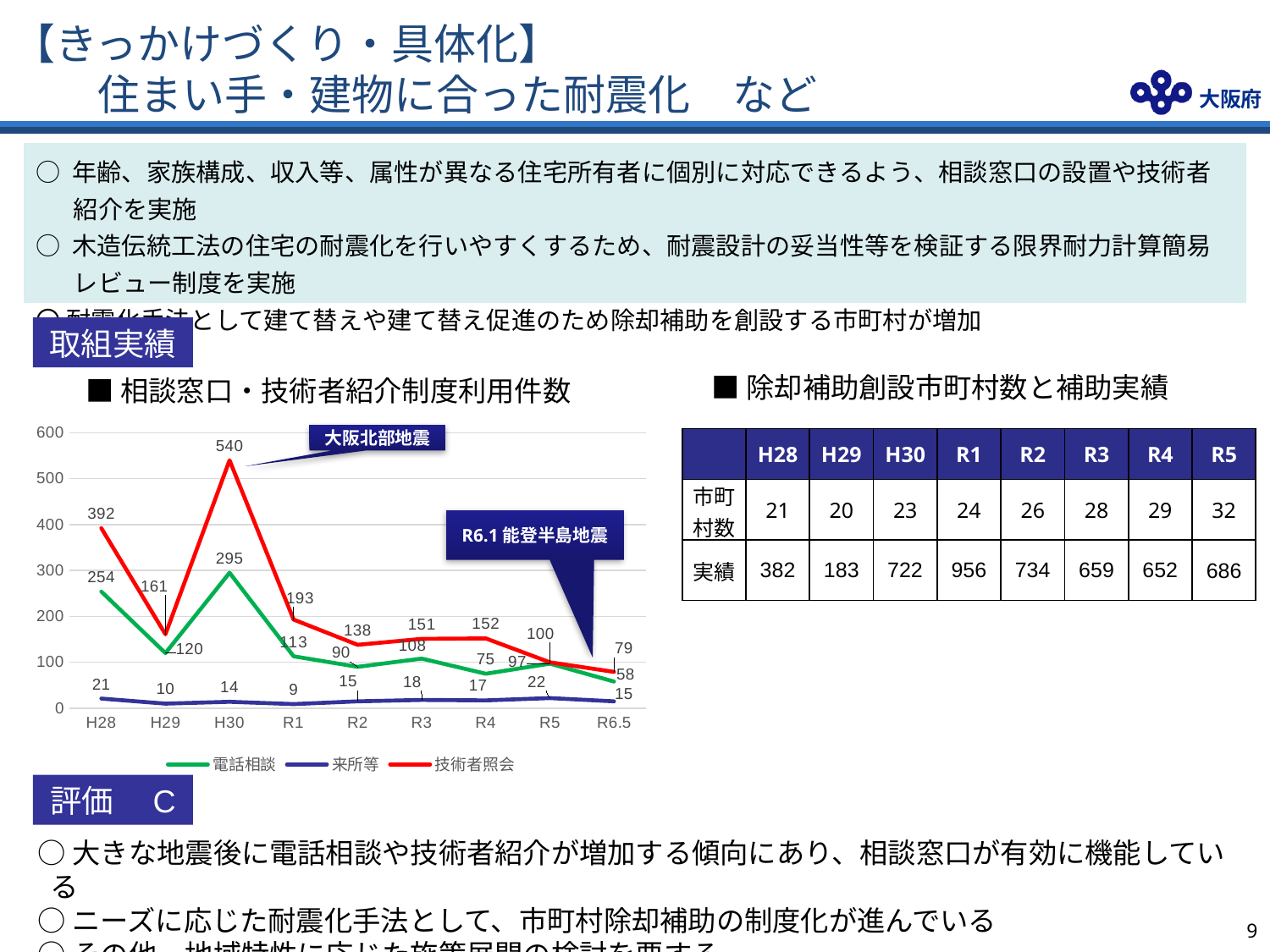
How many series does the legend of the 相談窓口・技術者紹介制度利用件数 chart list? 3 In the 相談窓口・技術者紹介制度利用件数 chart, what is the difference between the 技術者照会 values for H30 and H28? 148 What kind of chart is shown under the heading 相談窓口・技術者紹介制度利用件数? line chart In the 相談窓口・技術者紹介制度利用件数 chart, what is the value of 来所等 for R5? 22 In the 相談窓口・技術者紹介制度利用件数 chart, what is the value of 技術者照会 for H30? 540 In the 相談窓口・技術者紹介制度利用件数 chart, what is the value of 電話相談 for H28? 254 In the 相談窓口・技術者紹介制度利用件数 chart, does 技術者照会 rise or fall from H30 to R2? fall In the 相談窓口・技術者紹介制度利用件数 chart, in which year is 来所等 at its lowest? R1 In the 相談窓口・技術者紹介制度利用件数 chart, which event does the callout pointing to the H30 peak name? 大阪北部地震 In the 相談窓口・技術者紹介制度利用件数 chart, which is larger for H28: 電話相談 or 技術者照会? 技術者照会 How many time points are plotted along the x axis of the 相談窓口・技術者紹介制度利用件数 chart? 9 In the 相談窓口・技術者紹介制度利用件数 chart, in which year does 技術者照会 reach its highest value? H30